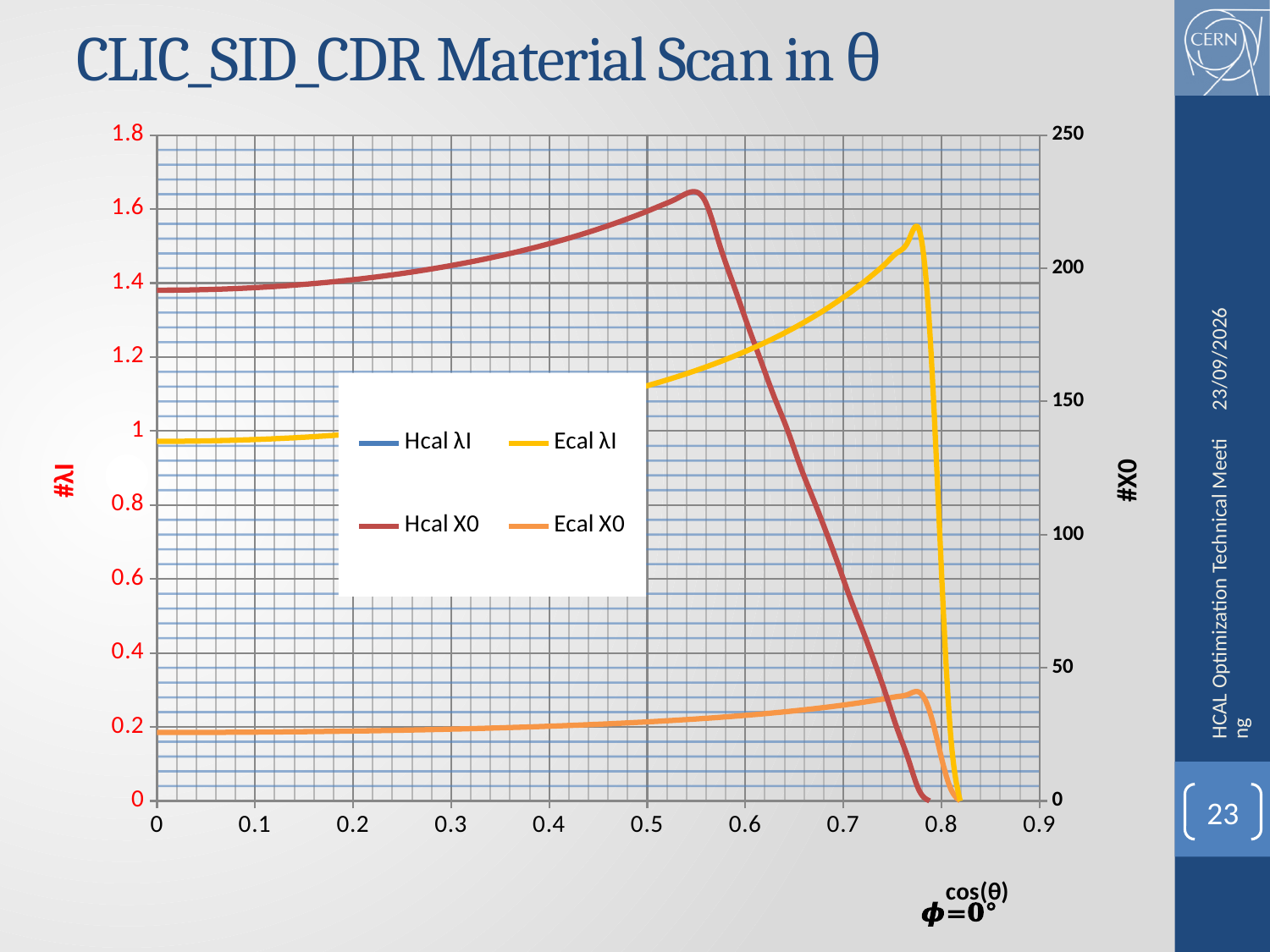
At cos(θ) = 0.2, is the Ecal X0 line above or below the 0.4 gridline of the left axis? below What kind of chart is shown on the slide? line chart What is the title of the left vertical axis of the chart? #λI How many tick labels are printed on the horizontal cos(θ) axis? 10 What are the four series named in the chart legend? Hcal λI, Ecal λI, Hcal X0, Ecal X0 What is the highest tick value shown on the right vertical axis (#X0)? 250 At cos(θ) = 0.3, which line is plotted higher on the chart, Hcal X0 or Ecal X0? Hcal X0 What is the highest tick value shown on the left vertical axis (#λI)? 1.8 Does the Hcal X0 line rise or fall as cos(θ) goes from 0.6 to 0.8? fall How many series does the chart legend list? 4 Does the Ecal λI line rise or fall as cos(θ) goes from 0.5 to 0.75? rise What is the largest cos(θ) value labelled on the horizontal axis? 0.9